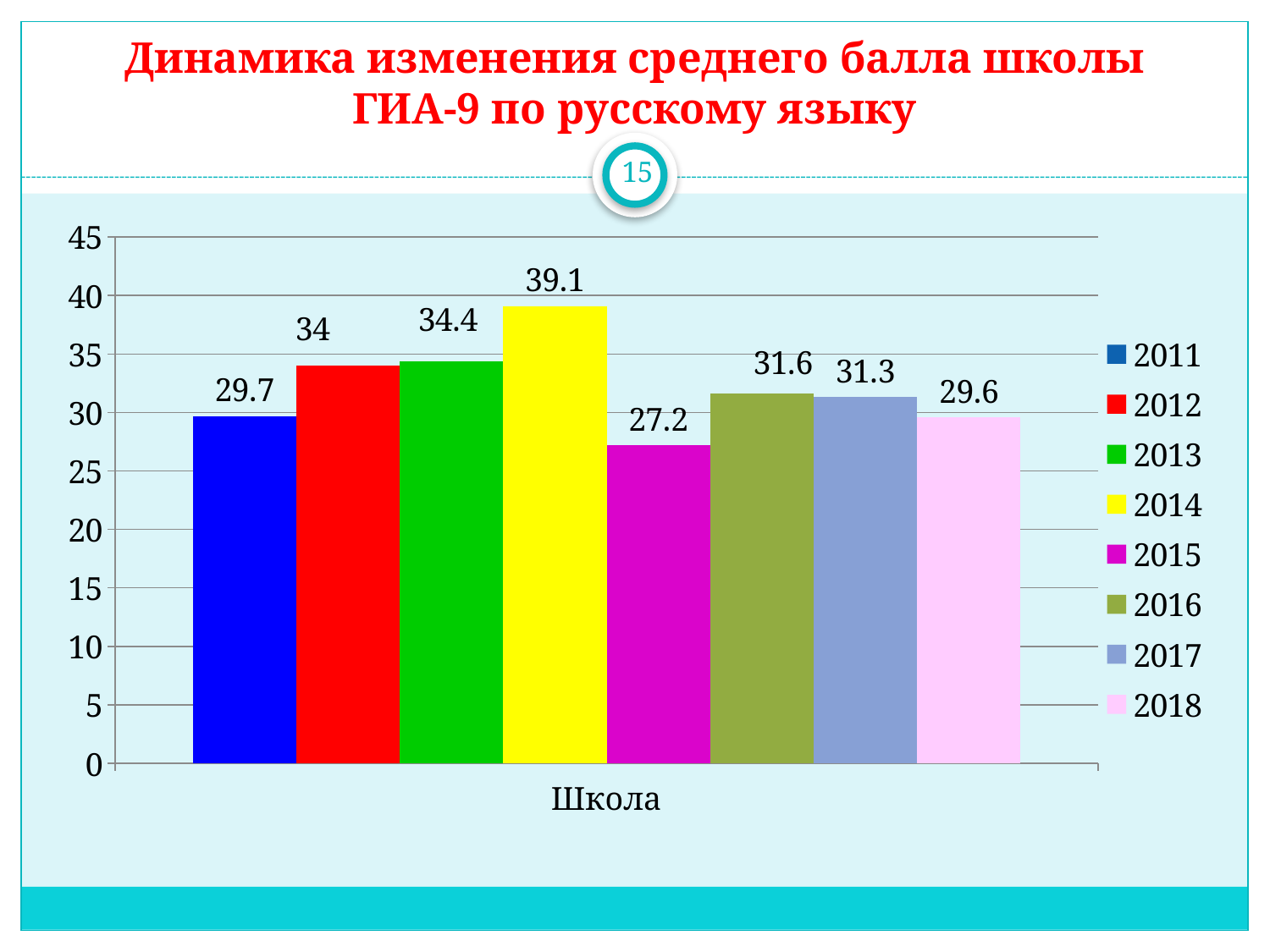
Which is larger, the value for 2016 or the value for 2018? 2016 What is the difference between the values for 2013 and 2012? 0.4 Which year has the highest value? 2014 What is the value for 2014? 39.1 Which year has the lowest value? 2015 What is the value for 2015? 27.2 What kind of chart is shown on the slide? bar chart What is the value for 2011? 29.7 What is the label on the x axis of the chart? Школа How many series does the legend list? 8 What is the difference between the values for 2014 and 2015? 11.9 Is the value for 2017 greater or less than 30? greater